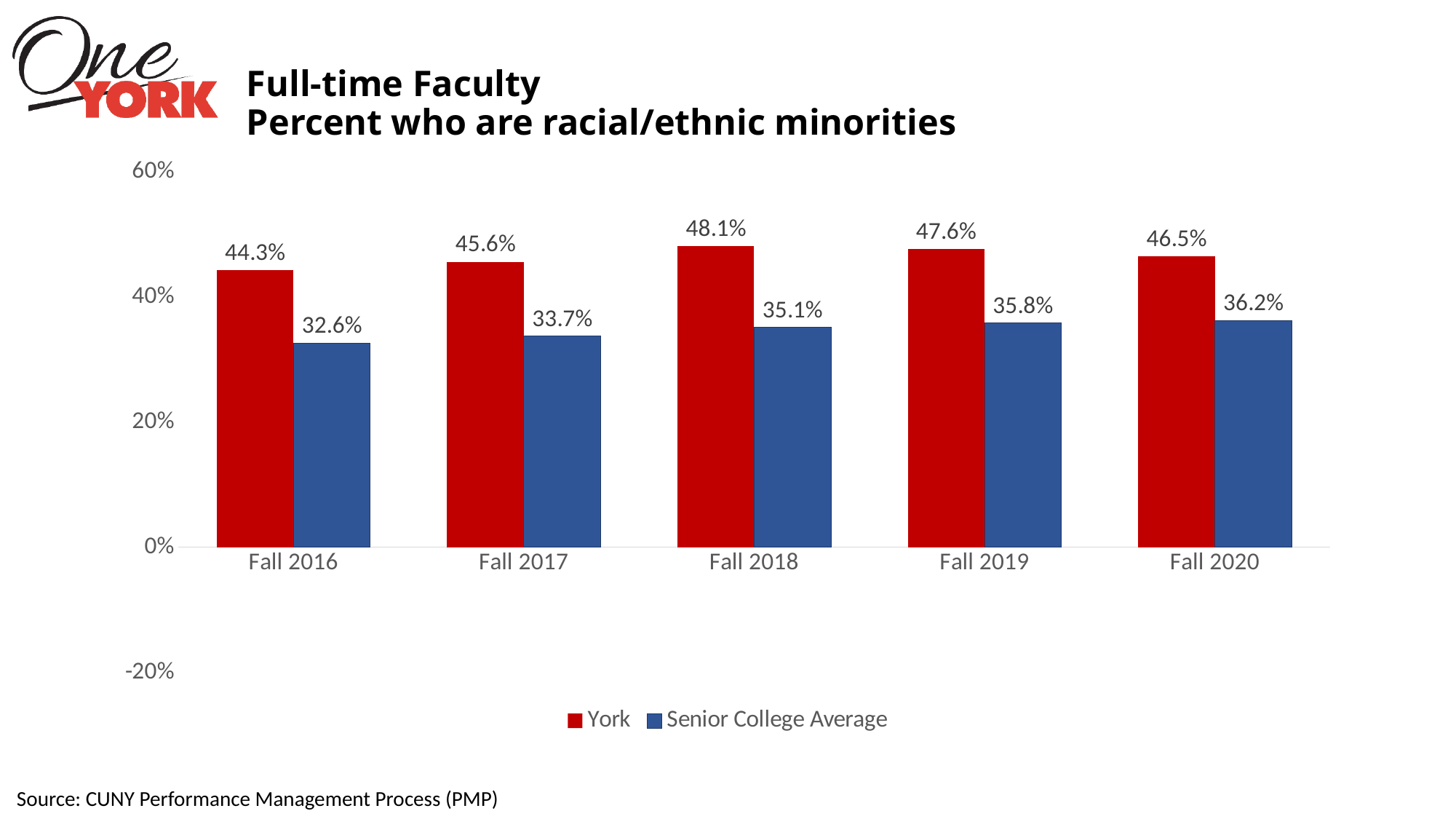
What is the Senior College Average value in Fall 2016? 32.6% Does the Senior College Average rise or fall from Fall 2016 to Fall 2020? Rise What is the value for York in Fall 2020? 46.5% Is the Senior College Average value for Fall 2020 greater or less than 40%? less How many series does the legend list? 2 What is the difference between York and the Senior College Average in Fall 2019? 11.8% What kind of chart is shown on the slide? Bar chart In which year is the York value highest? Fall 2018 Which is larger in Fall 2017, York or the Senior College Average? York In which year is the Senior College Average value lowest? Fall 2016 How many years are shown on the x axis? 5 What is the value for York in Fall 2018? 48.1%